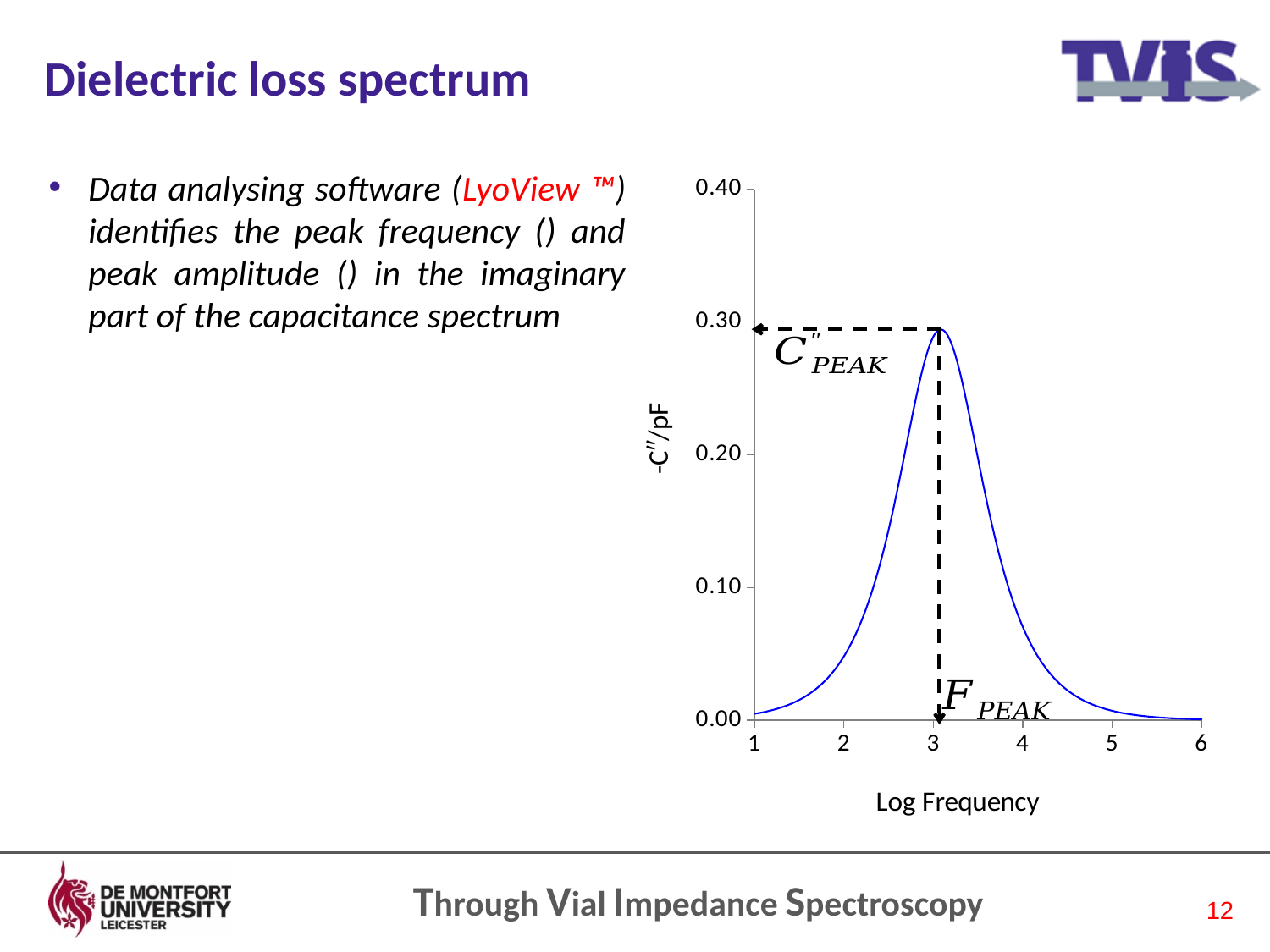
What is the title of the x axis of the chart? Log Frequency Is the peak value of the curve greater or less than 0.20? greater Is the peak value of the curve greater or less than 0.40? less Does the curve rise or fall as log frequency increases from 1 to 3? rise What kind of chart is shown on the slide? line chart How many labelled tick values are shown on the x axis? 6 What is the label on the y axis of the chart? -C''/pF Is the value of the curve at log frequency 5 greater or less than 0.10? less Near which labelled x-axis value does the curve reach its maximum? 3 Does the curve rise or fall as log frequency increases from 4 to 6? fall